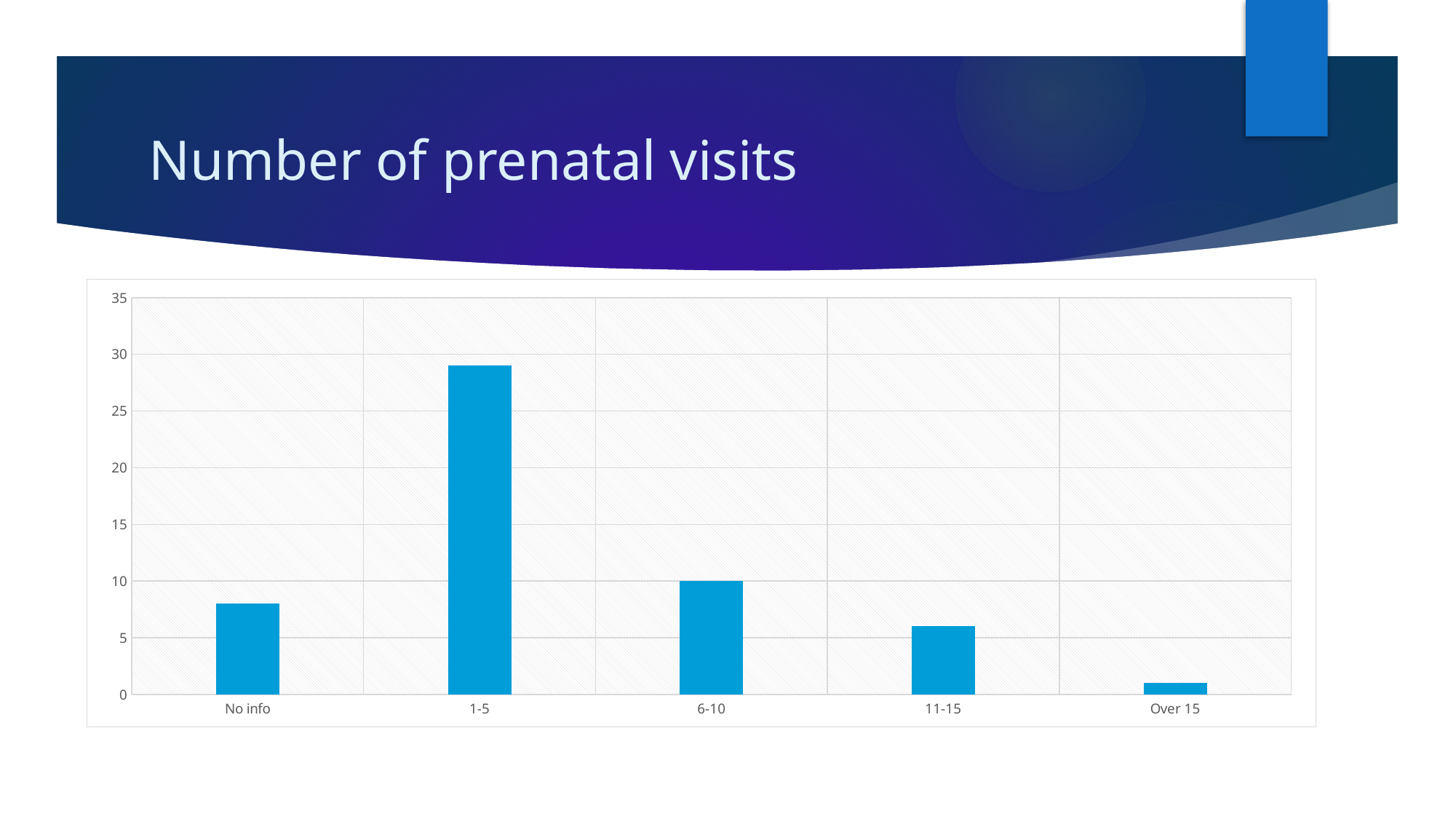
Which category has the lowest bar? Over 15 Is the value for No info greater or less than 10? less Is the value for 1-5 greater or less than 25? greater Is the value for Over 15 greater or less than 5? less Which category has the highest bar? 1-5 Which is larger, the value for No info or the value for 11-15? No info How many categories are shown on the x axis of the chart? 5 What is the title of the slide containing the chart? Number of prenatal visits What kind of chart is shown on the slide? bar chart What is the value for the 6-10 category? 10